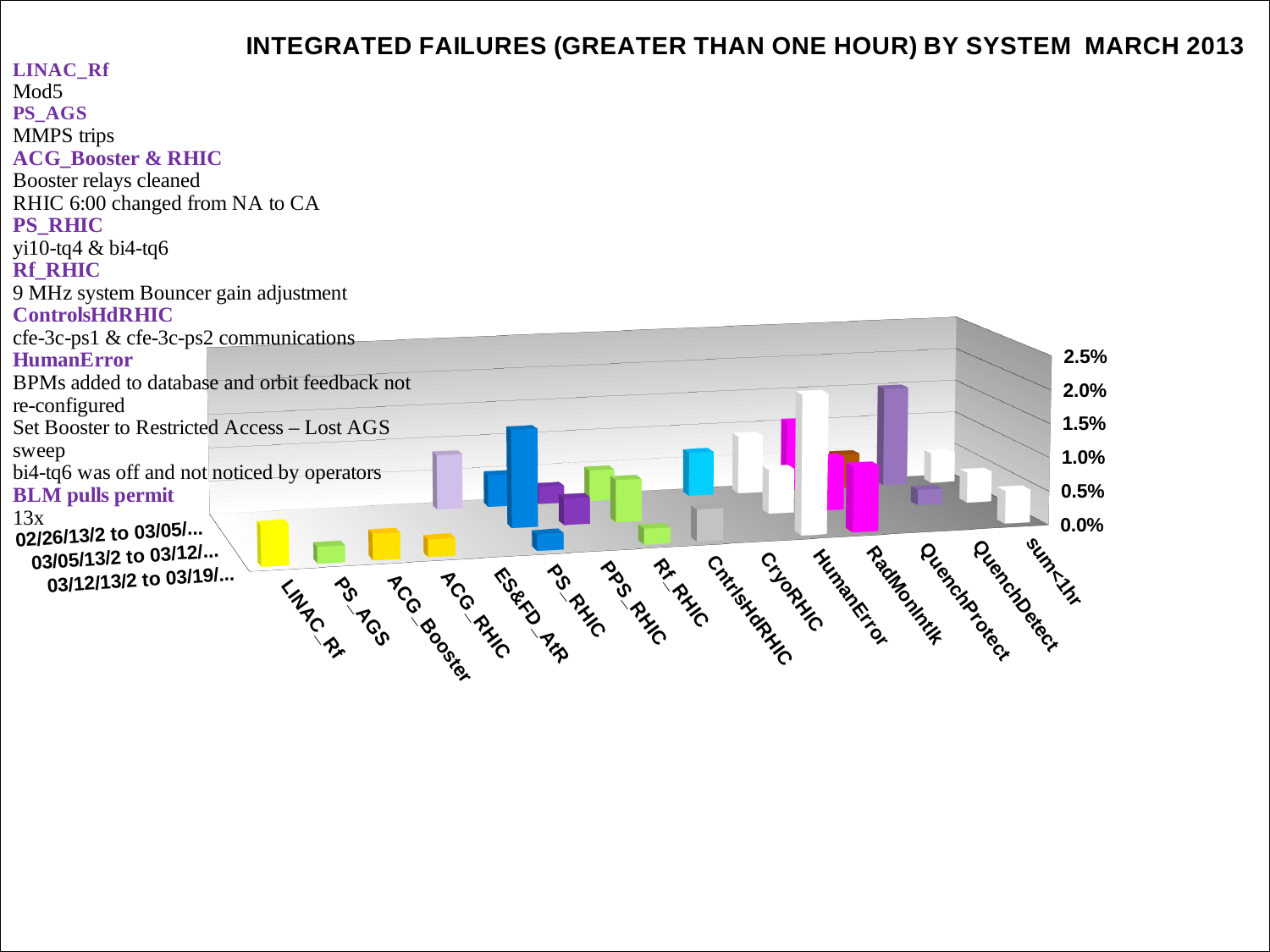
What kind of chart is shown on the slide? bar chart What is the last category listed on the chart's x axis? sum<1hr What is the first system category listed on the chart's x axis? LINAC_Rf How many system categories are shown along the x axis of the chart? 15 What is the title of the chart? INTEGRATED FAILURES (GREATER THAN ONE HOUR) BY SYSTEM MARCH 2013 How many date-range series (rows) does the chart plot? 3 What is the highest value labelled on the chart's vertical axis? 2.5%